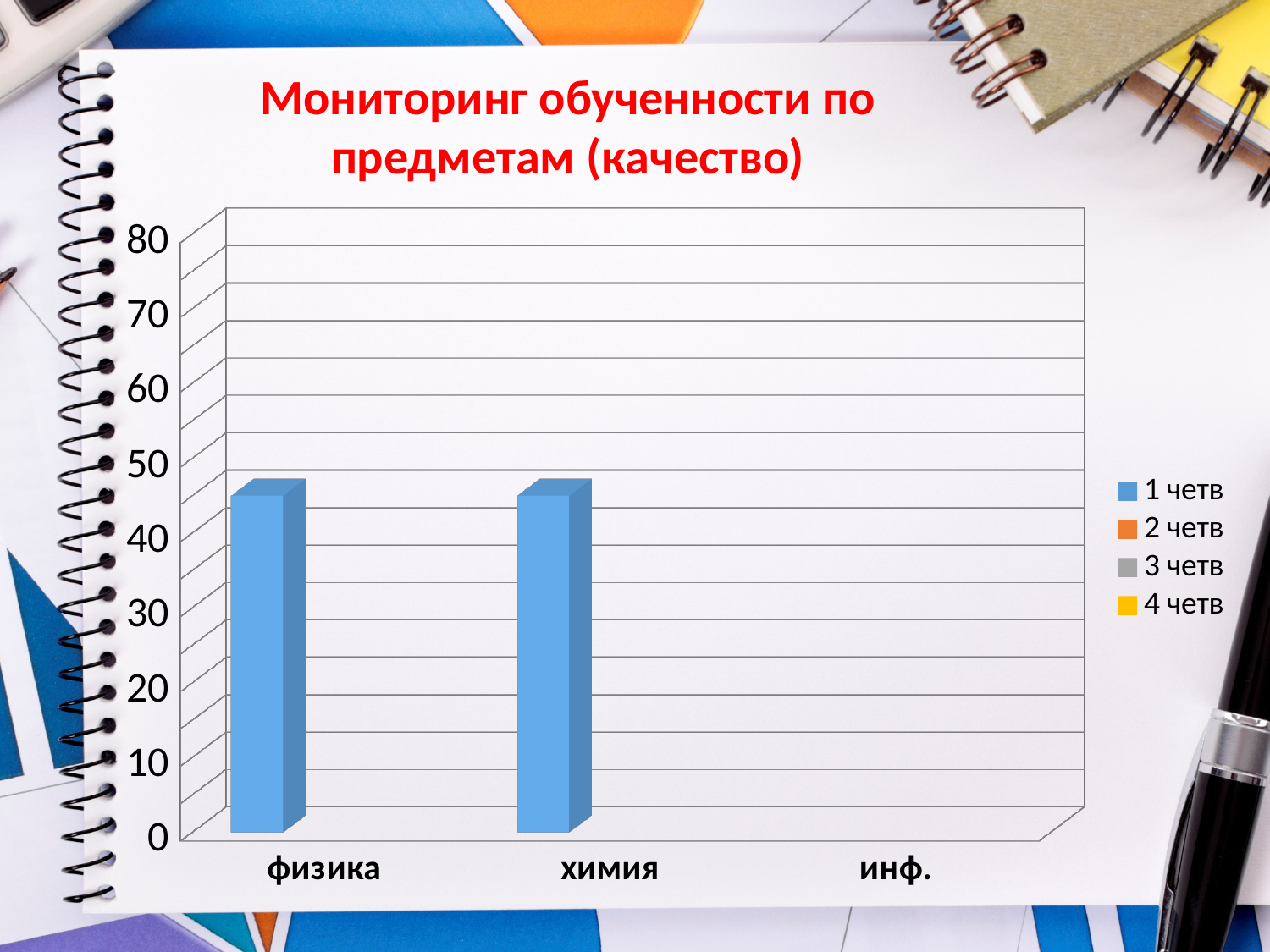
Which series are listed in the chart's legend? 1 четв, 2 четв, 3 четв, 4 четв How many categories are shown on the x axis of the chart? 3 What is the title of the chart? Мониторинг обученности по предметам (качество) Is the value for физика in the 1 четв series greater or less than 50? less Is the value for химия in the 1 четв series greater or less than 40? greater What is the highest value shown on the vertical axis of the chart? 80 Is the value for химия in the 1 четв series greater or less than 50? less What kind of chart is shown on the slide? bar chart Which category on the x axis has no bar plotted? инф. How many series does the chart's legend list? 4